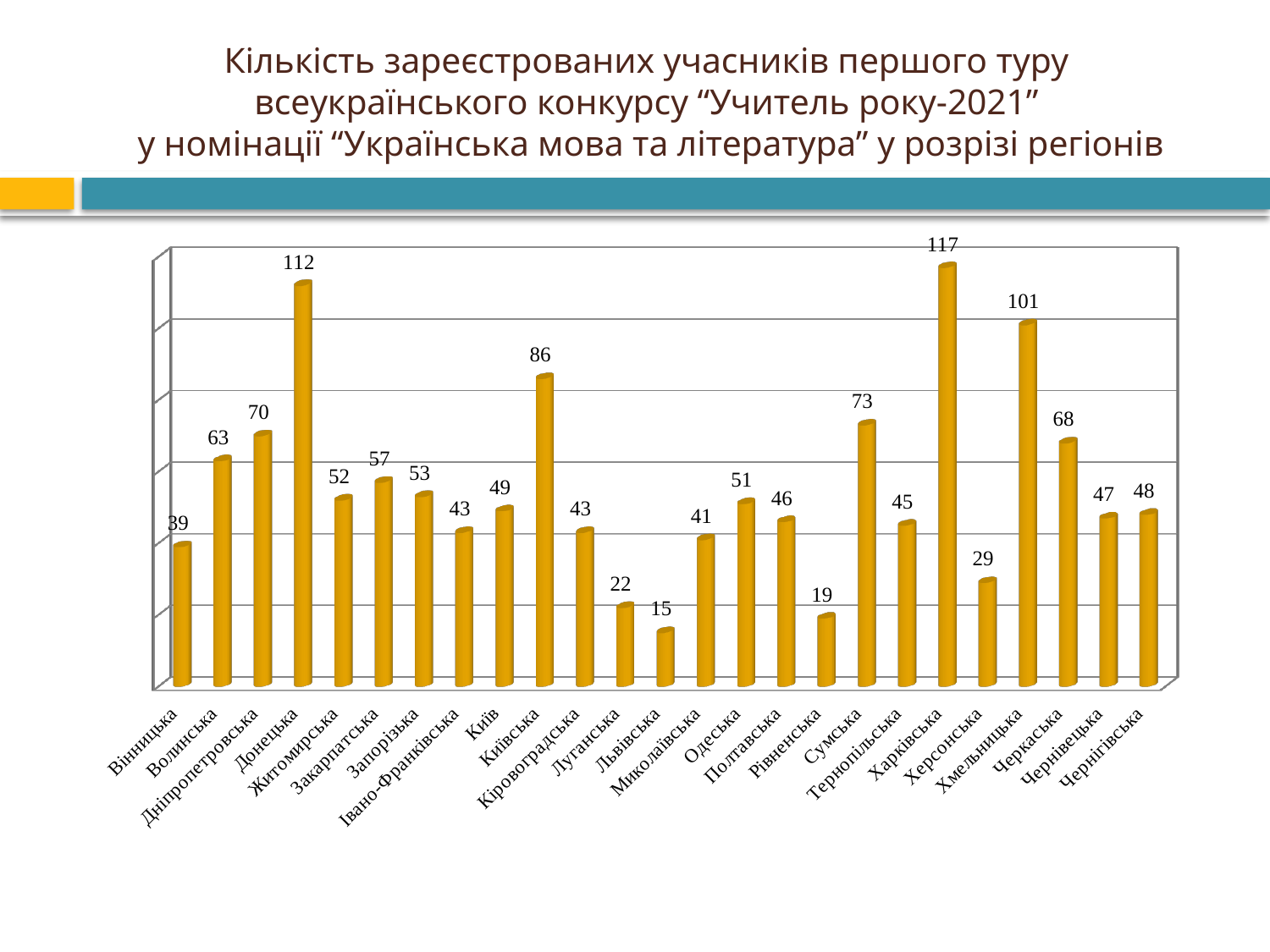
What is the difference between the values for Донецька and Київська? 26 What is the difference between the values for Харківська and Хмельницька? 16 What is the value for Київ? 49 How many regions (categories) are plotted on the chart? 25 Which region has the highest number of registered participants? Харківська What kind of chart is shown on the slide? bar chart Which region has the lowest number of registered participants? Львівська What is the value for Рівненська? 19 Which is larger, the value for Сумська or the value for Черкаська? Сумська What is the value for Донецька? 112 Which is larger, the value for Луганська or the value for Херсонська? Херсонська What is the value for Хмельницька? 101